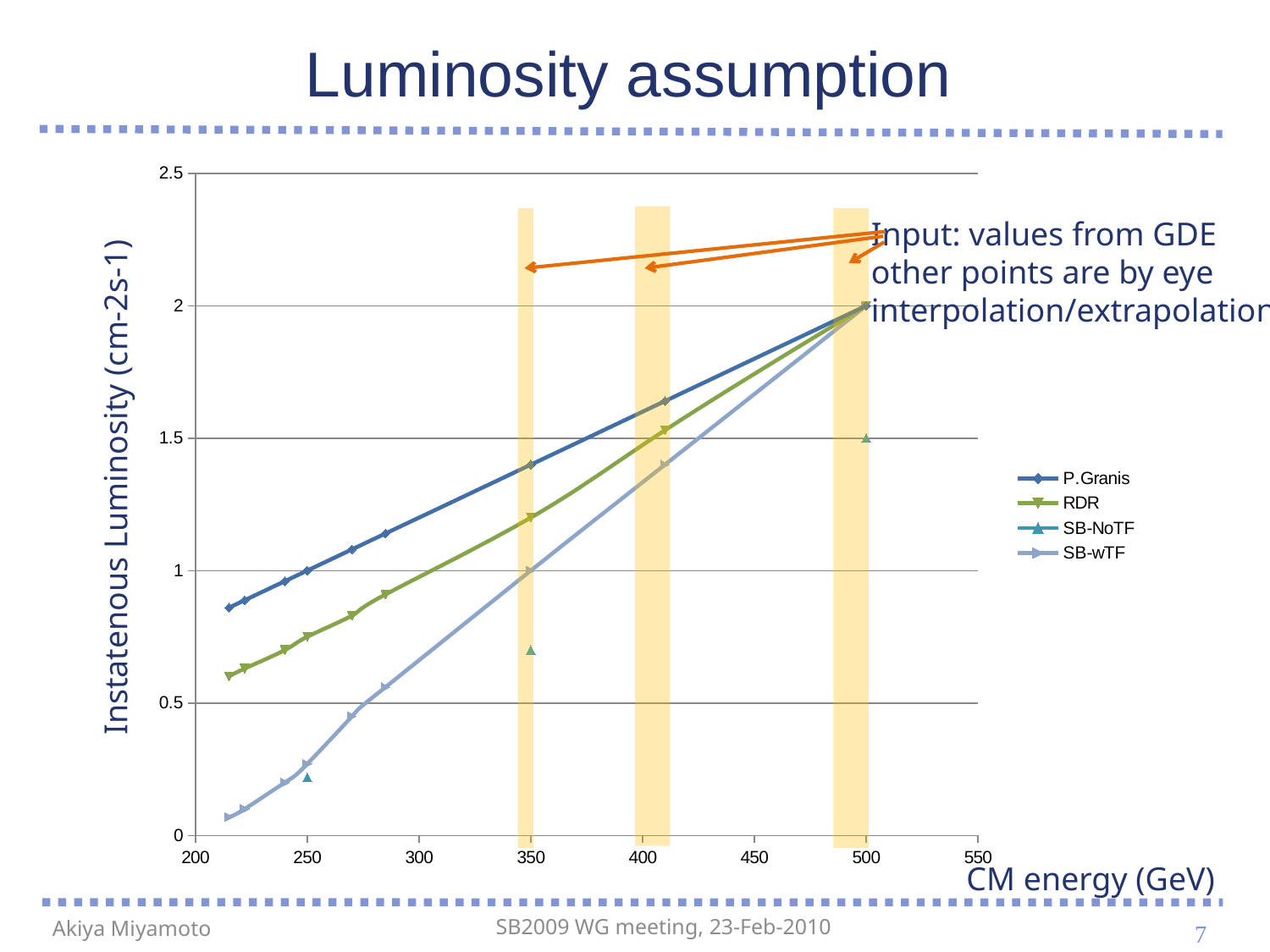
What kind of chart is shown on the slide? line chart What is the title of the slide's chart? Luminosity assumption What is the label of the x axis of the chart? CM energy (GeV) Is the SB-wTF value at 250 GeV greater or less than 0.5? less Does the P.Granis luminosity rise or fall as CM energy increases? rise Is the RDR value at 350 GeV greater or less than 1? greater At 350 GeV, which series has the lowest luminosity? SB-NoTF Is the P.Granis value at 350 GeV greater or less than 1.5? less At 350 GeV, which series has the higher luminosity, P.Granis or RDR? P.Granis How many series does the chart legend list? 4 At 400 GeV, which series has the higher luminosity, RDR or SB-wTF? RDR